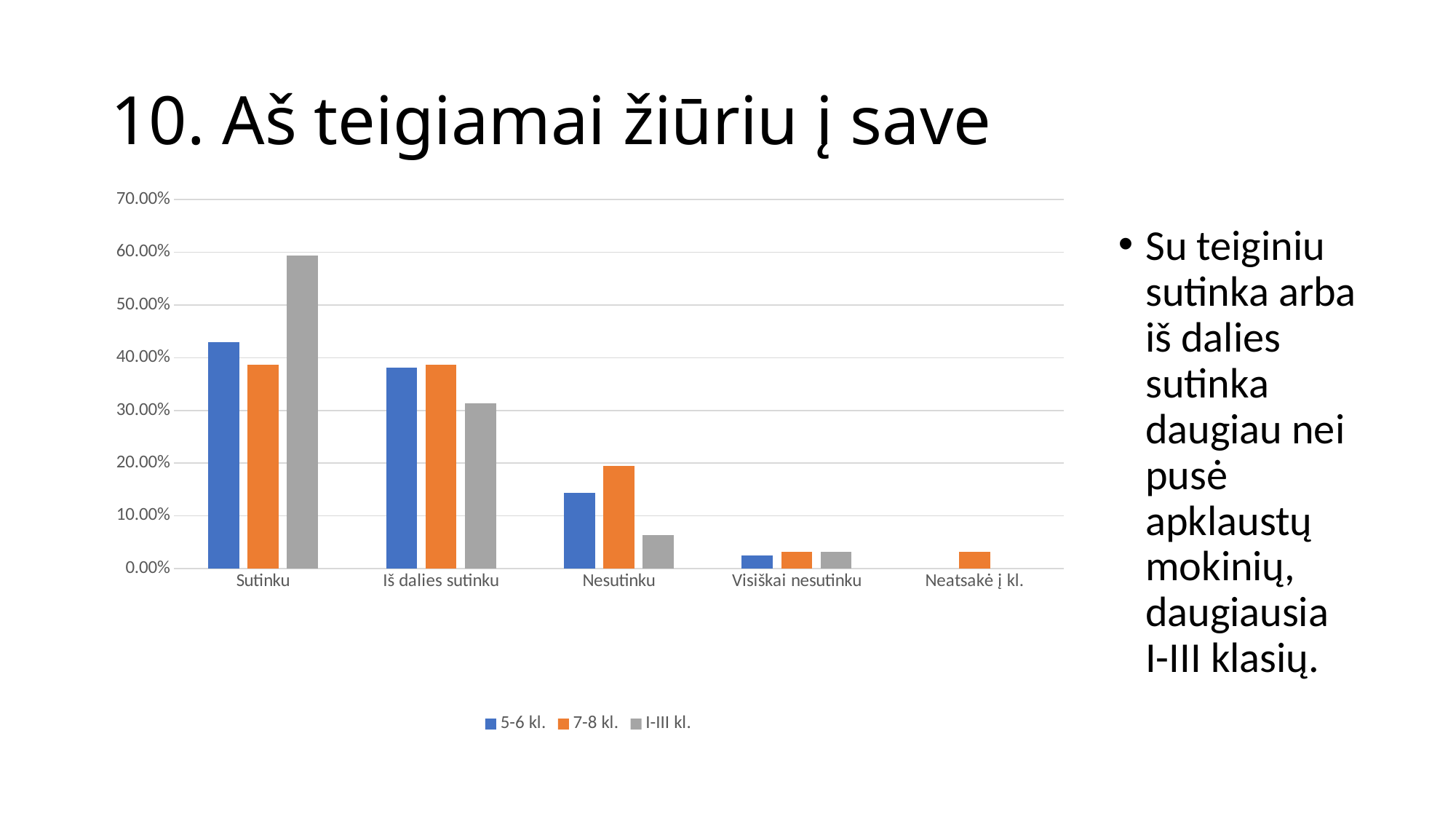
How many categories are shown on the x axis? 5 Which series is the only one with a bar in the Neatsakė į kl. category? 7-8 kl. How many series does the legend list? 3 Is the value for I-III kl. in the Sutinku category greater or less than 50.00%? greater In the Sutinku category, which is larger: the 5-6 kl. bar or the I-III kl. bar? I-III kl. In the Sutinku category, which series has the lowest bar? 7-8 kl. Do the I-III kl. bars rise or fall from Sutinku to Visiškai nesutinku? fall What kind of chart is shown on the slide? bar chart Is the value for I-III kl. in the Nesutinku category greater or less than 10.00%? less In the Nesutinku category, which is larger: the 7-8 kl. bar or the I-III kl. bar? 7-8 kl. Which category has the highest bar for the I-III kl. series? Sutinku Is the value for 5-6 kl. in the Sutinku category greater or less than 40.00%? greater